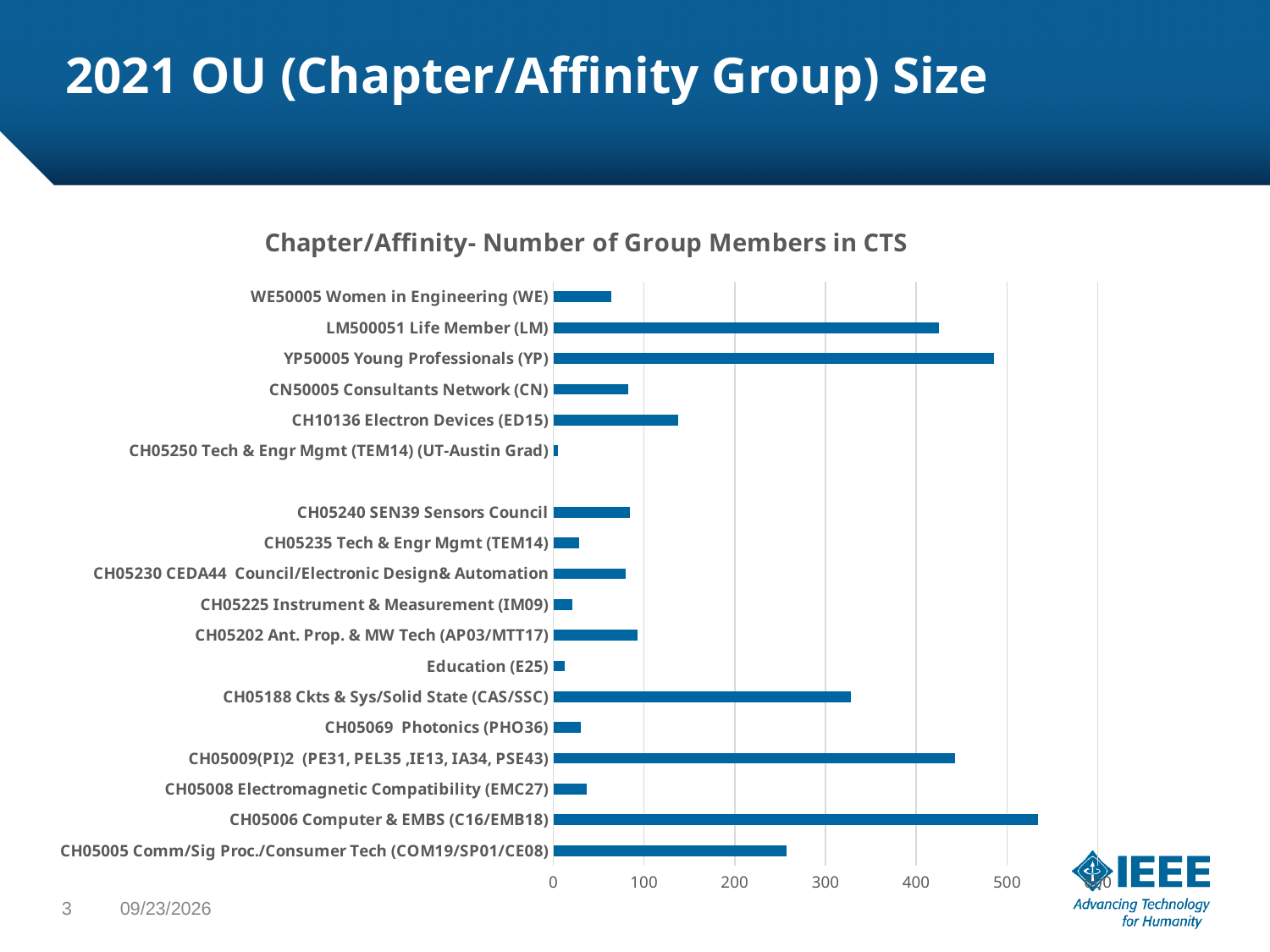
Which category has the highest number of group members? CH05006 Computer & EMBS (C16/EMB18) Is the value for CH05005 Comm/Sig Proc./Consumer Tech (COM19/SP01/CE08) greater or less than 200? greater What is the title of the chart? Chapter/Affinity- Number of Group Members in CTS Is the value for WE50005 Women in Engineering (WE) greater or less than 100? less Is the value for CH05240 SEN39 Sensors Council greater or less than 100? less Which category has the lowest number of group members? CH05250 Tech & Engr Mgmt (TEM14) (UT-Austin Grad) Which has more group members, YP50005 Young Professionals (YP) or LM500051 Life Member (LM)? YP50005 Young Professionals (YP) What kind of chart is shown on the slide? bar chart Which has more group members, CH05188 Ckts & Sys/Solid State (CAS/SSC) or CH05005 Comm/Sig Proc./Consumer Tech (COM19/SP01/CE08)? CH05188 Ckts & Sys/Solid State (CAS/SSC)